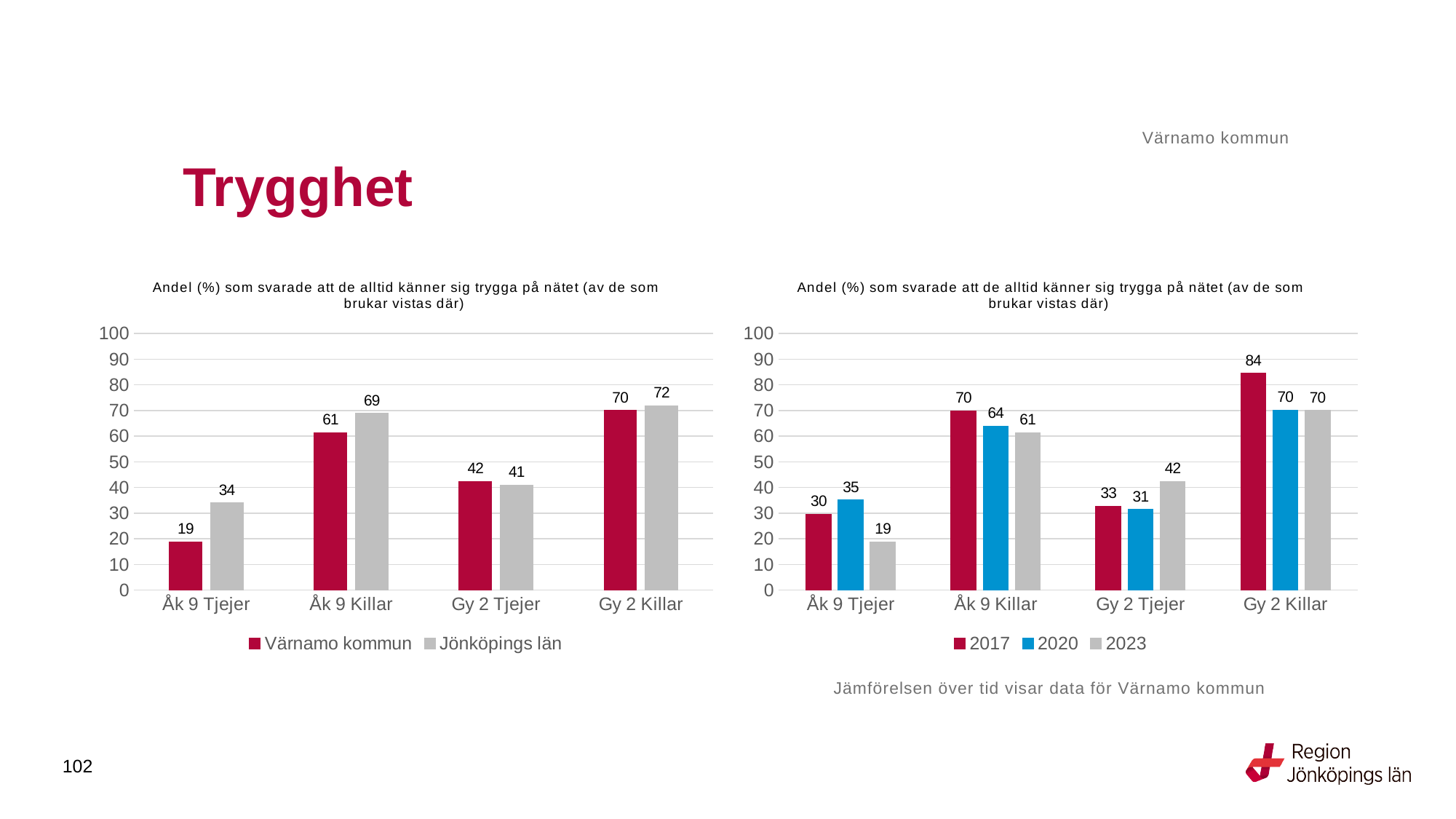
In the right chart, which category has the lowest value for 2023? Åk 9 Tjejer In the left chart, what is the value for Värnamo kommun for Åk 9 Tjejer? 19 In the right chart, what is the value for 2017 for Gy 2 Killar? 84 In the left chart, which is larger for Gy 2 Tjejer: Värnamo kommun or Jönköpings län? Värnamo kommun What kind of chart is the right chart? Bar chart In the right chart, what is the difference between 2017 and 2023 for Åk 9 Killar? 9 How many series does the legend of the left chart list? 2 In the left chart, which category has the highest value for Värnamo kommun? Gy 2 Killar In the left chart, what is the difference between Jönköpings län and Värnamo kommun for Åk 9 Tjejer? 15 In the left chart, what is the value for Jönköpings län for Åk 9 Killar? 69 In the right chart, what is the value for 2023 for Gy 2 Tjejer? 42 How many series does the legend of the right chart list? 3